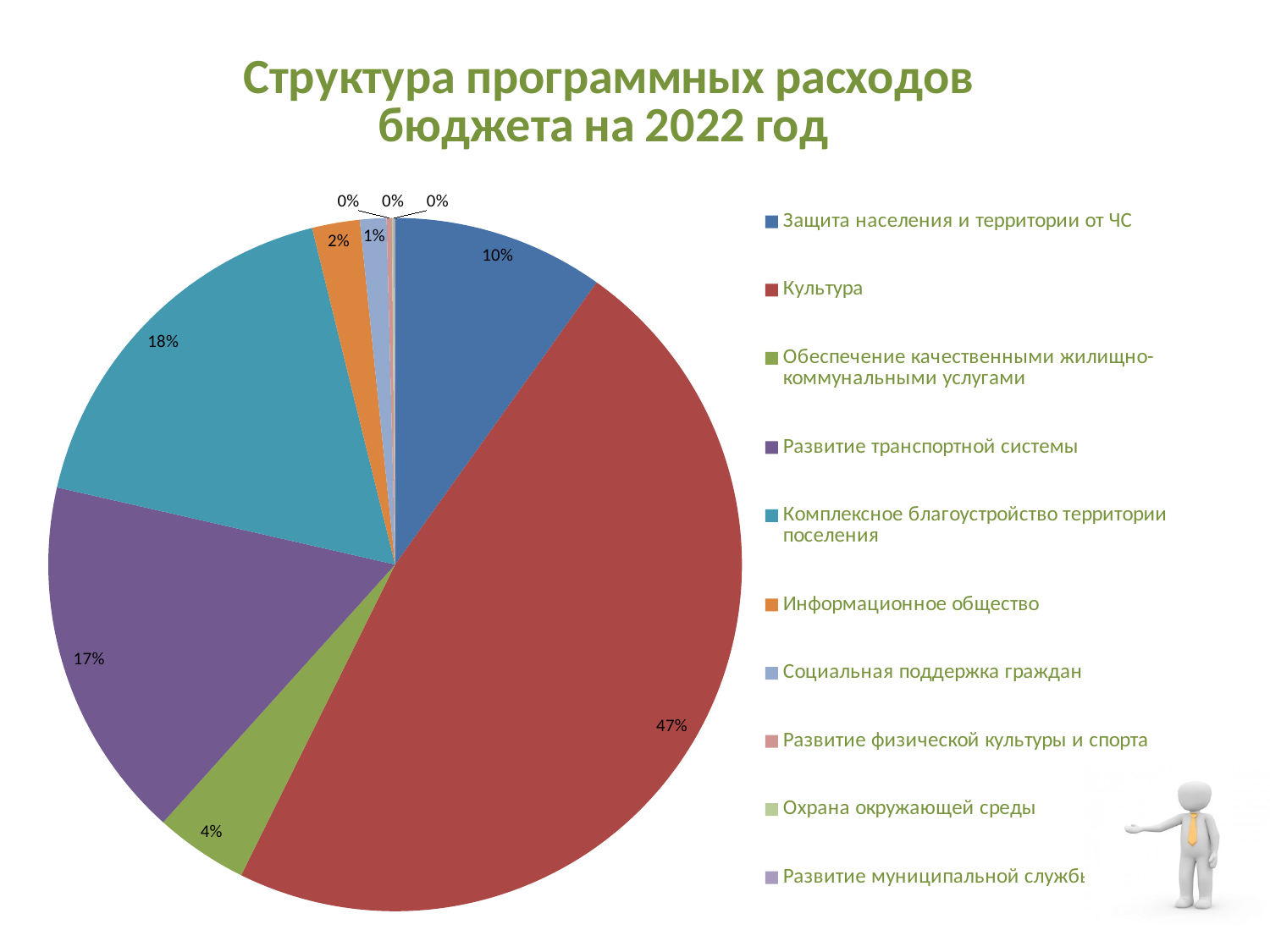
What share of the pie is "Обеспечение качественными жилищно-коммунальными услугами"? 4% What is the difference between the shares of "Культура" and "Защита населения и территории от ЧС"? 37% Which is larger: the share of "Комплексное благоустройство территории поселения" or the share of "Обеспечение качественными жилищно-коммунальными услугами"? Комплексное благоустройство территории поселения What share of the pie is "Информационное общество"? 2% What share of the pie is "Комплексное благоустройство территории поселения"? 18% What kind of chart is shown on the slide? pie chart How many categories does the legend list? 10 Which category has the largest share of the pie? Культура What is the title of the chart? Структура программных расходов бюджета на 2022 год